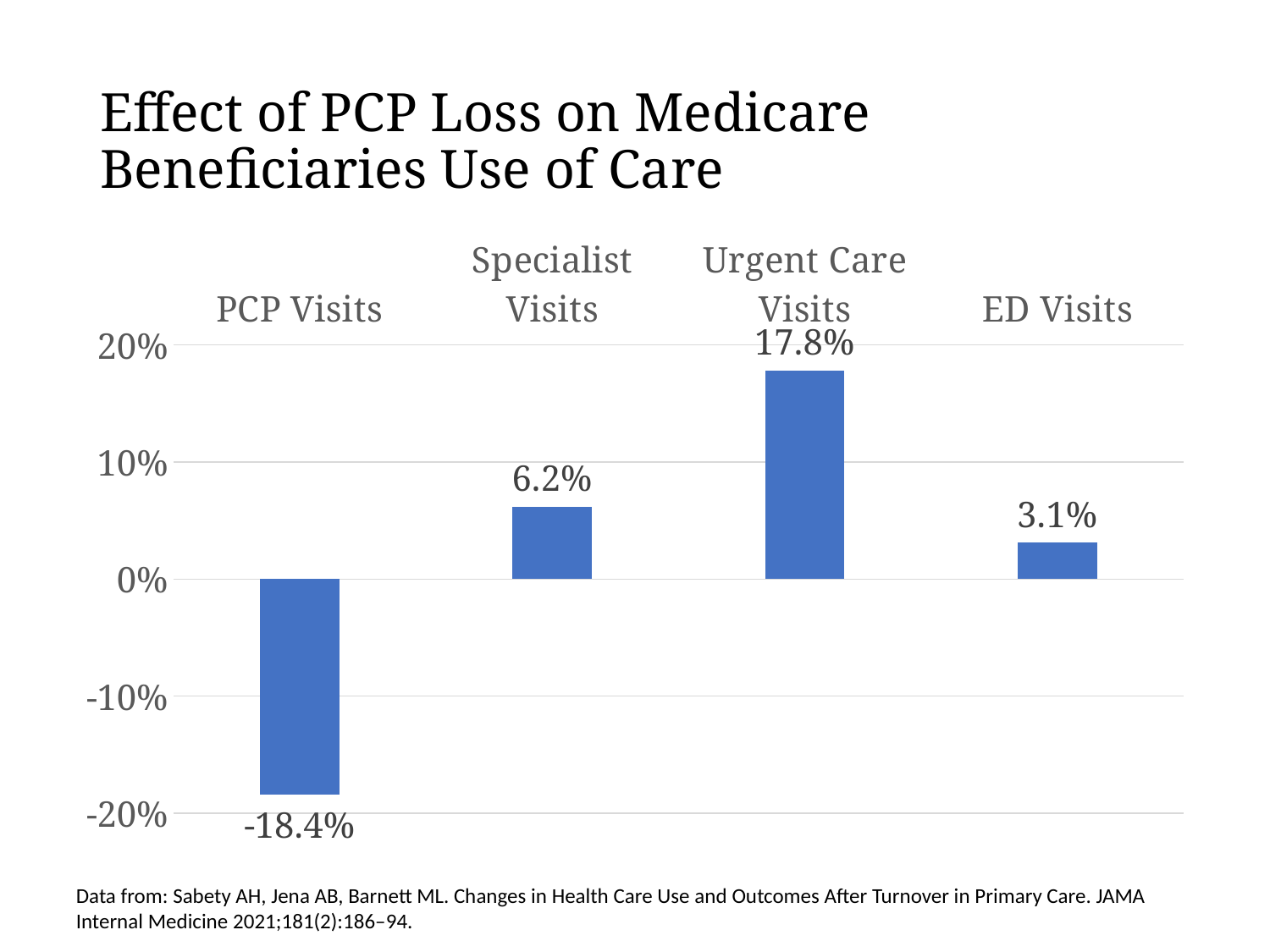
What is the title of the slide? Effect of PCP Loss on Medicare Beneficiaries Use of Care What is the value for ED Visits? 3.1% Which is larger, the value for Specialist Visits or the value for ED Visits? Specialist Visits Is the value for Urgent Care Visits greater or less than 10%? greater What is the value for PCP Visits? -18.4% Which category has the lowest value? PCP Visits Which category has the highest value? Urgent Care Visits What is the value for Urgent Care Visits? 17.8% What is the value for Specialist Visits? 6.2% What is the difference between the values for Urgent Care Visits and Specialist Visits? 11.6% How many categories are shown in the chart? 4 What kind of chart is shown on the slide? bar chart